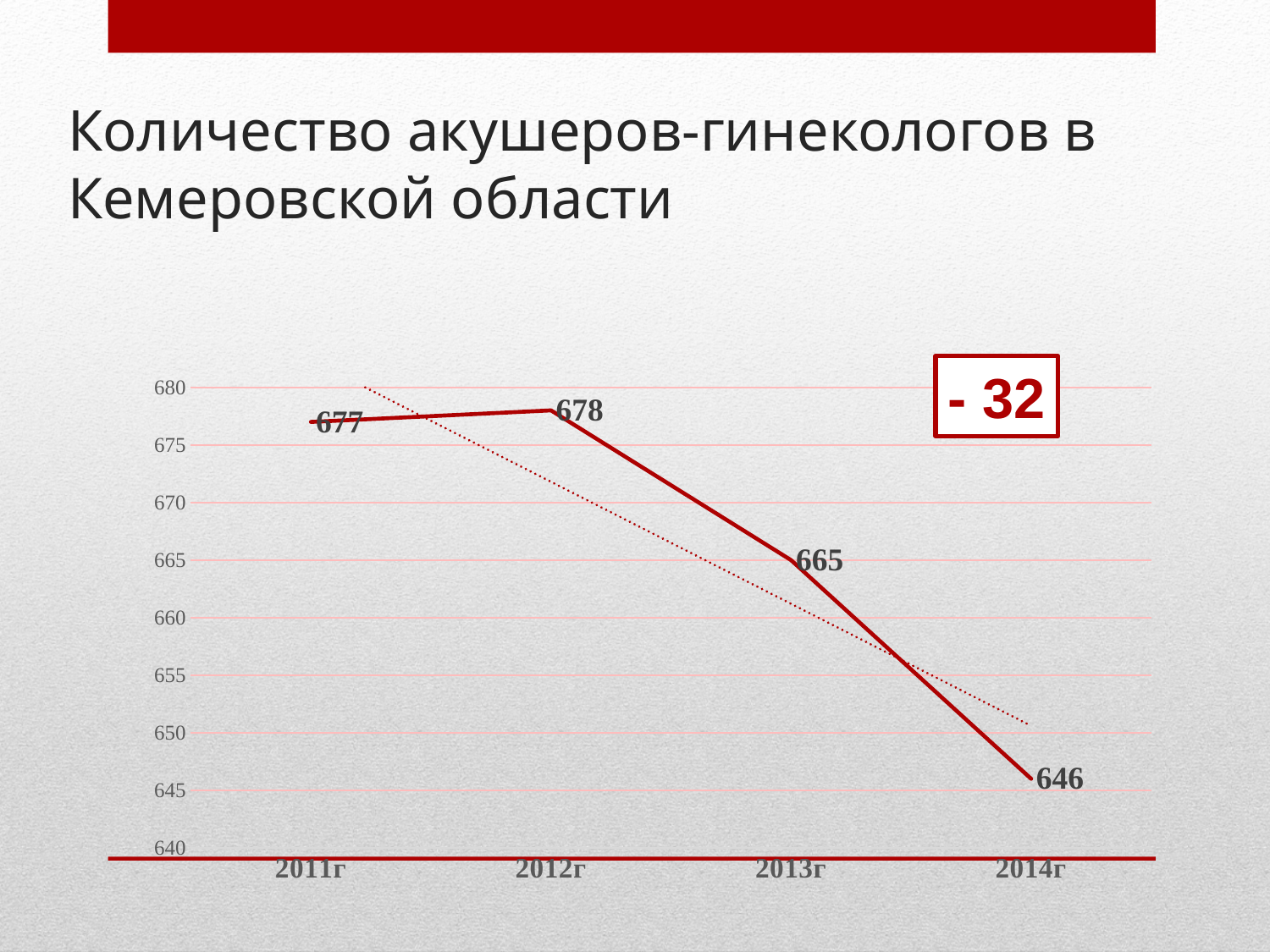
How many years are plotted on the chart? 4 Which is larger, the value for 2011г or the value for 2013г? 2011г What is the value for 2011г? 677 What is the value for 2012г? 678 Which year has the highest value? 2012г What is the value for 2014г? 646 What is the value for 2013г? 665 What kind of chart is shown on the slide? line chart What is the difference between the values for 2013г and 2014г? 19 Do the values rise or fall from 2012г to 2014г? fall Which year has the lowest value? 2014г What is the difference between the values for 2012г and 2014г? 32